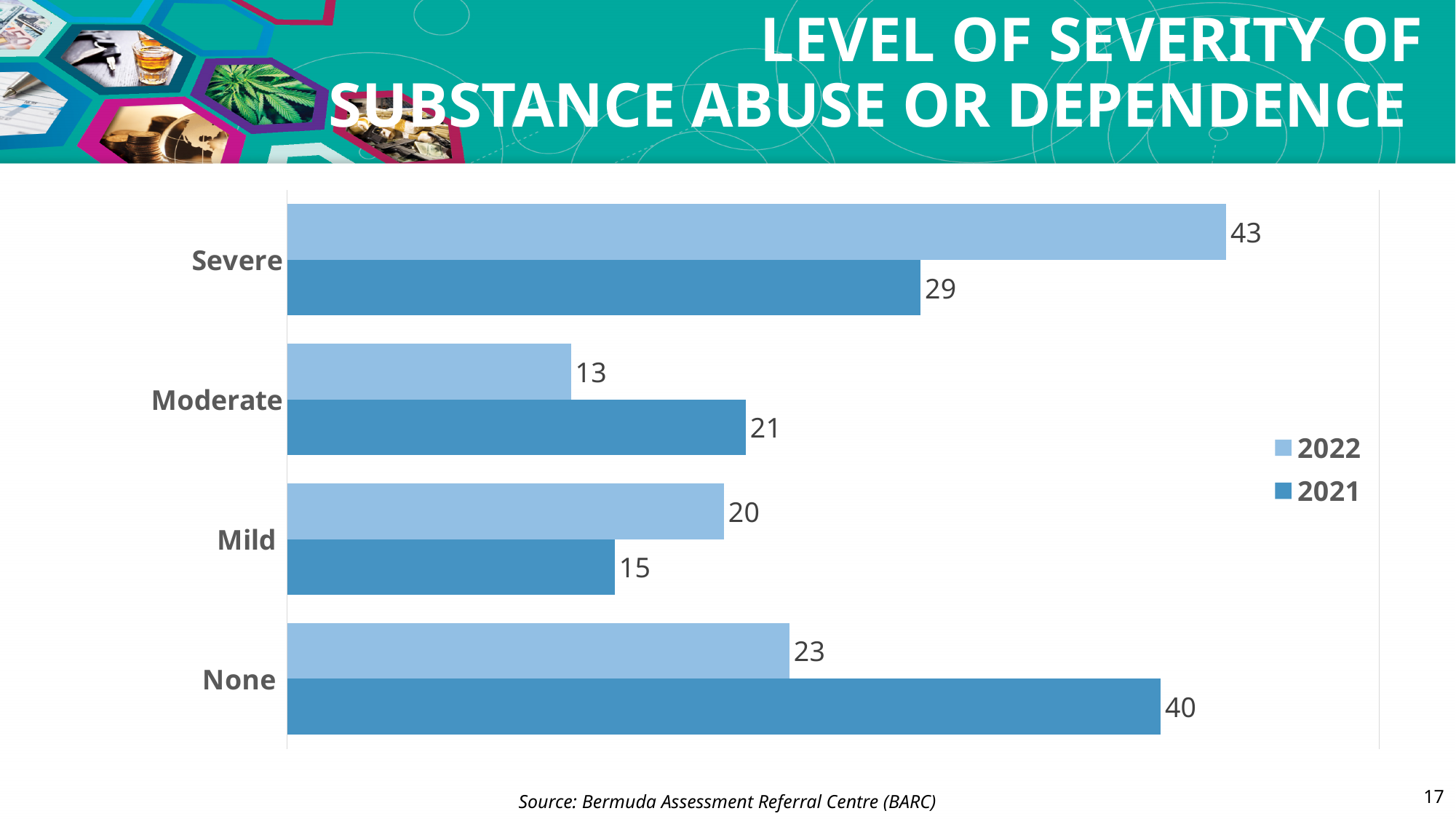
How many series does the legend list? 2 What is the difference between the 2022 and 2021 values for Severe? 14 What is the difference between the 2021 and 2022 values for None? 17 What is the value for Moderate in 2021? 21 Which severity level has the lowest value for 2021? Mild What kind of chart is shown on the slide? Bar chart What is the value for None in 2021? 40 Which is larger for Moderate, the 2022 value or the 2021 value? 2021 What is the value for Severe in 2022? 43 What is the value for Mild in 2022? 20 Which severity level has the highest value for 2022? Severe How many severity categories are shown on the chart? 4